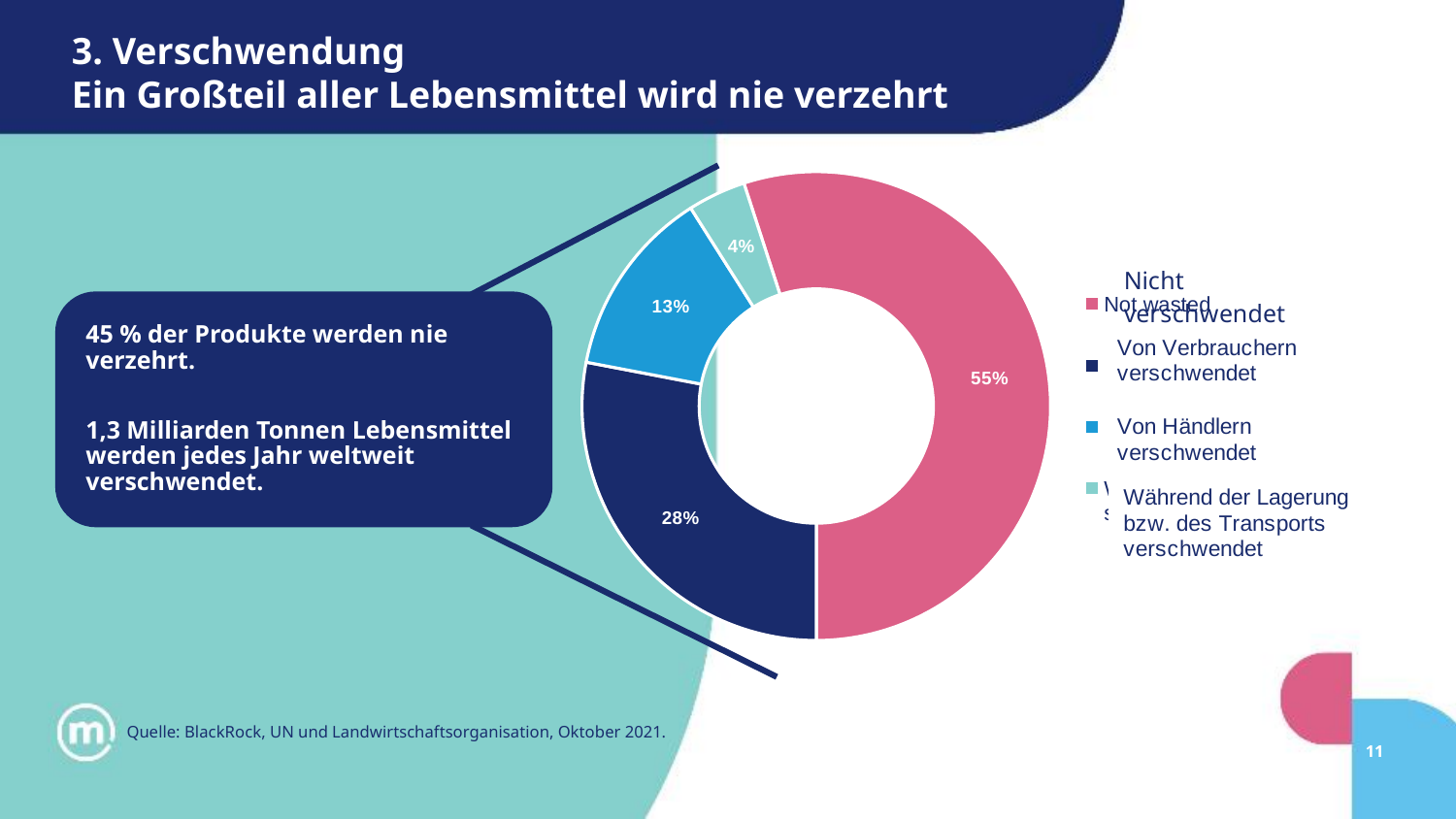
Which is larger: the share wasted by consumers (Von Verbrauchern verschwendet) or the share wasted by retailers (Von Händlern verschwendet)? Von Verbrauchern verschwendet Which slice of the pie chart is the largest? Nicht verschwendet What percentage is shown for "Von Verbrauchern verschwendet"? 28% What share of the pie is labelled "Nicht verschwendet"? 55% What kind of chart is shown on the slide? Pie chart (donut) What colour is the "Nicht verschwendet" slice? Pink What percentage is shown for "Von Händlern verschwendet"? 13% What percentage is shown for "Während der Lagerung bzw. des Transports verschwendet"? 4% How many slices does the pie chart have? 4 What is the combined percentage of the three "verschwendet" (wasted) slices? 45% Which slice of the pie chart is the smallest? Während der Lagerung bzw. des Transports verschwendet What is the difference in percentage points between the "Von Verbrauchern verschwendet" slice and the "Von Händlern verschwendet" slice? 15 percentage points